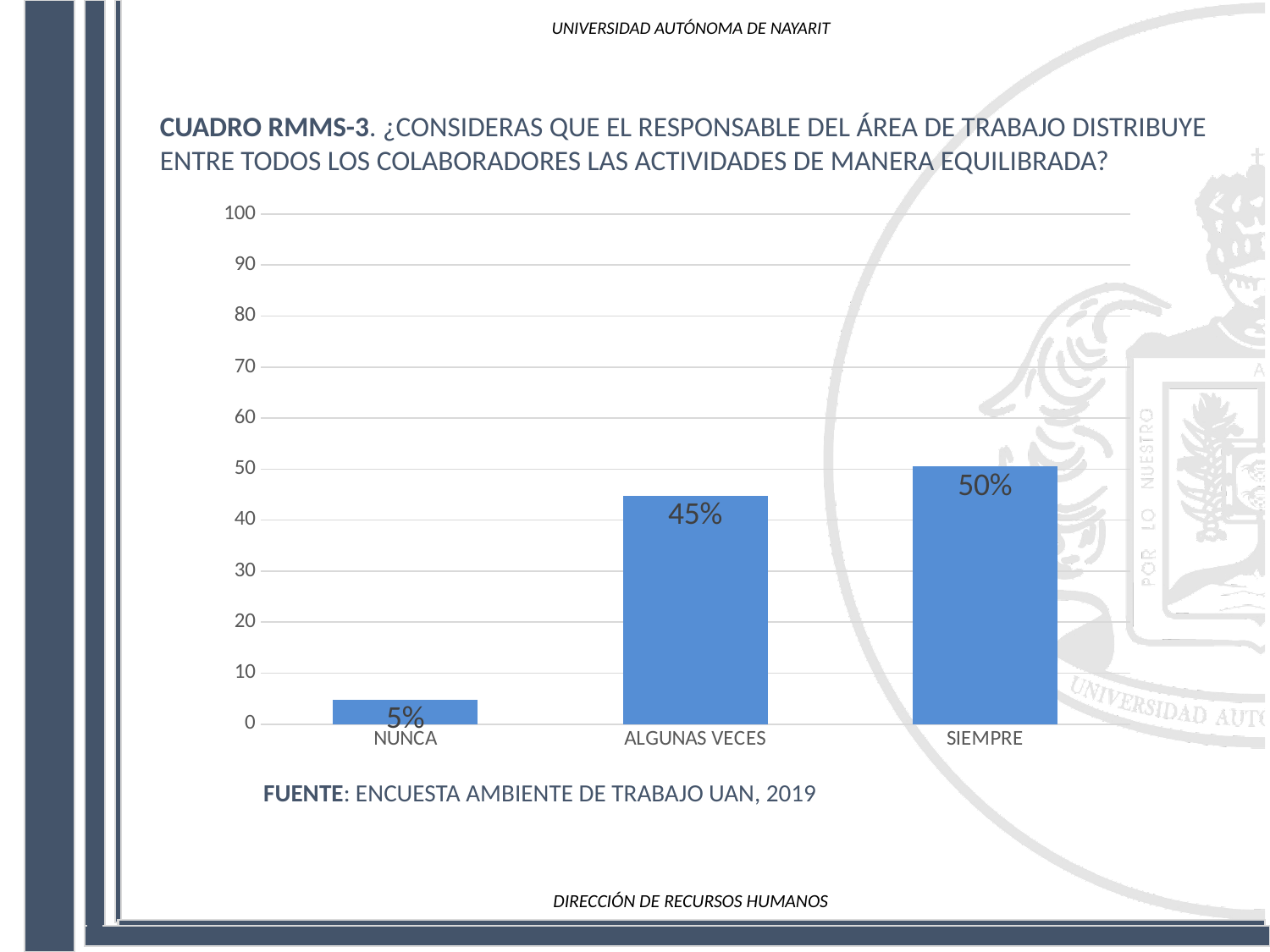
What is the value for SIEMPRE? 50% Is the value for SIEMPRE greater or less than 40? greater Which category has the lowest value? NUNCA How many categories are shown on the x axis? 3 What is the difference between the values for SIEMPRE and ALGUNAS VECES? 5% Which is larger, the value for NUNCA or the value for ALGUNAS VECES? ALGUNAS VECES What is the value for ALGUNAS VECES? 45% What kind of chart is shown on the slide? bar chart Do the values rise or fall from NUNCA to SIEMPRE along the x axis? rise What is the value for NUNCA? 5% Which category has the highest value? SIEMPRE What is the difference between the values for ALGUNAS VECES and NUNCA? 40%